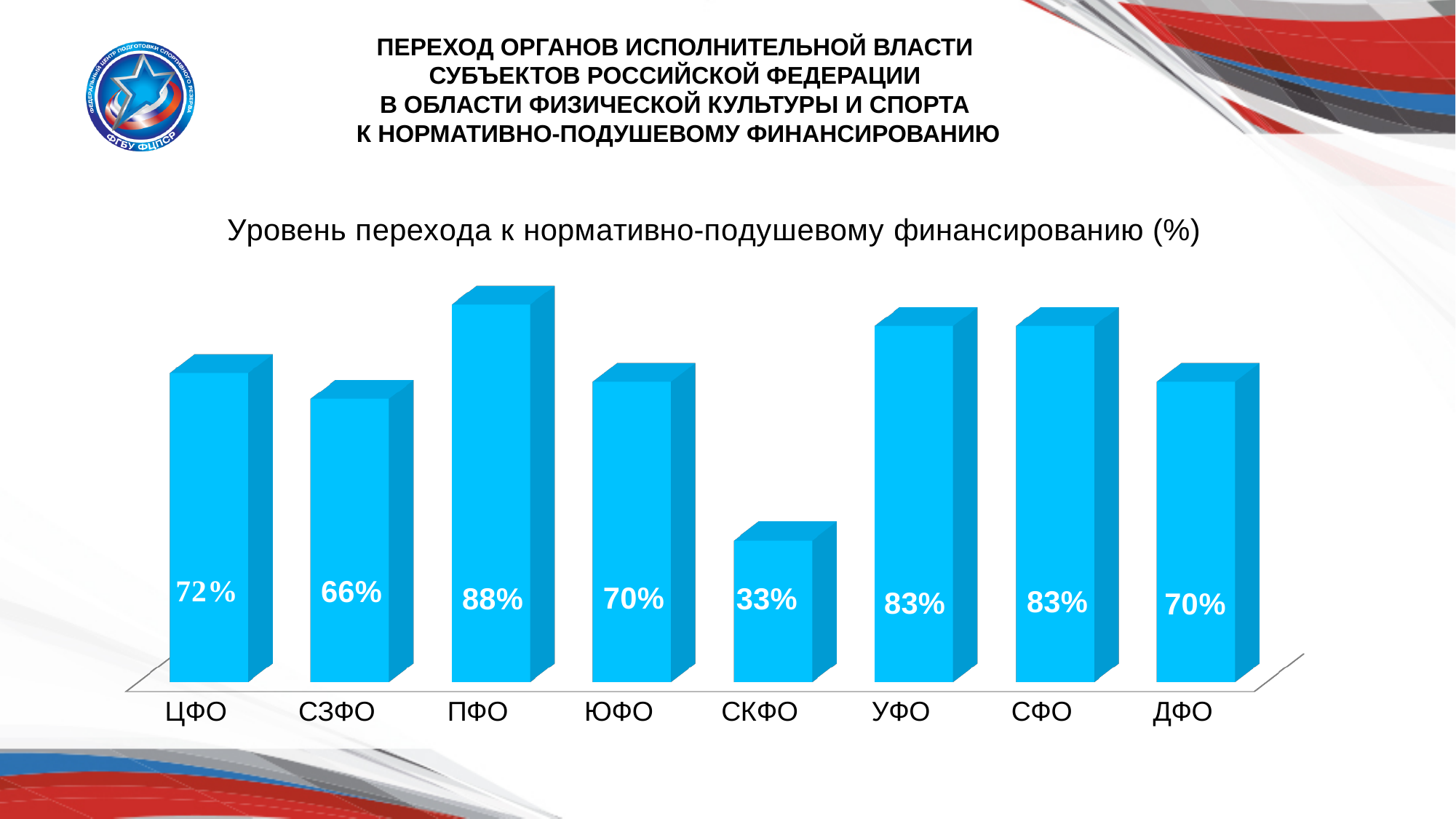
What is the value for СКФО? 33% What kind of chart is shown on the slide? bar chart What is the title of the chart? Уровень перехода к нормативно-подушевому финансированию (%) What is the difference between the values for ПФО and СКФО? 55% What is the value for СЗФО? 66% Which category has the highest value? ПФО What is the difference between the values for ЦФО and СЗФО? 6% What is the value for ПФО? 88% Which category has the lowest value? СКФО How many categories are shown on the x axis? 8 What is the value for ЦФО? 72% Which is larger, the value for УФО or the value for ДФО? УФО